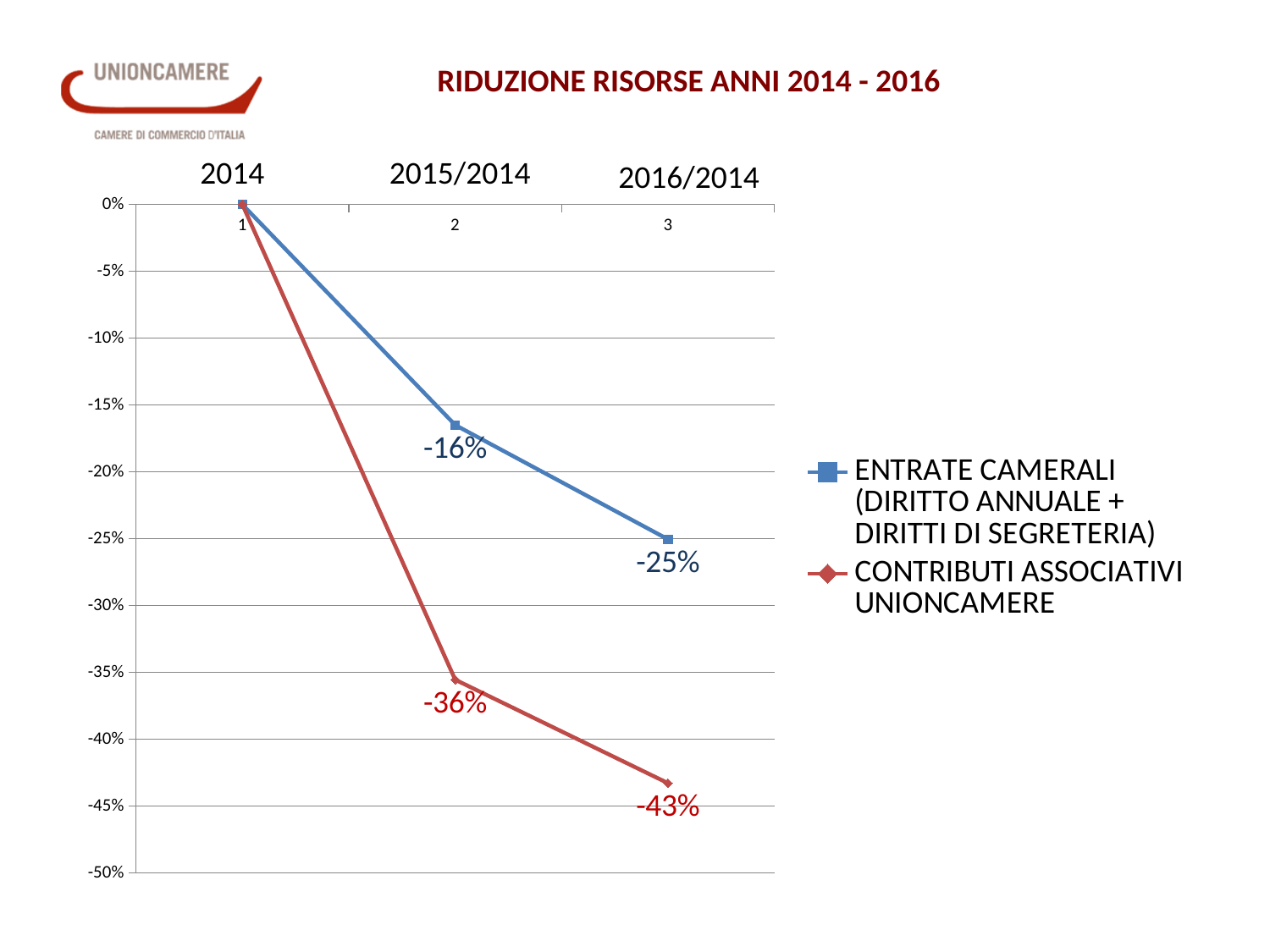
Which series has the lower value at 2015/2014? CONTRIBUTI ASSOCIATIVI UNIONCAMERE How many series does the legend list? 2 What is the difference between the CONTRIBUTI ASSOCIATIVI UNIONCAMERE value and the ENTRATE CAMERALI value at 2016/2014? 18% Do the values for CONTRIBUTI ASSOCIATIVI UNIONCAMERE rise or fall from 2014 to 2016/2014? fall What is the value for CONTRIBUTI ASSOCIATIVI UNIONCAMERE at 2015/2014? -36% What is the value for CONTRIBUTI ASSOCIATIVI UNIONCAMERE at 2016/2014? -43% What is the value for ENTRATE CAMERALI (DIRITTO ANNUALE + DIRITTI DI SEGRETERIA) at 2015/2014? -16% What is the title of the chart? RIDUZIONE RISORSE ANNI 2014 - 2016 Which colour is used for the CONTRIBUTI ASSOCIATIVI UNIONCAMERE line? red How many points are plotted for each series? 3 What is the value for ENTRATE CAMERALI (DIRITTO ANNUALE + DIRITTI DI SEGRETERIA) at 2016/2014? -25% What kind of chart is shown on the slide? line chart